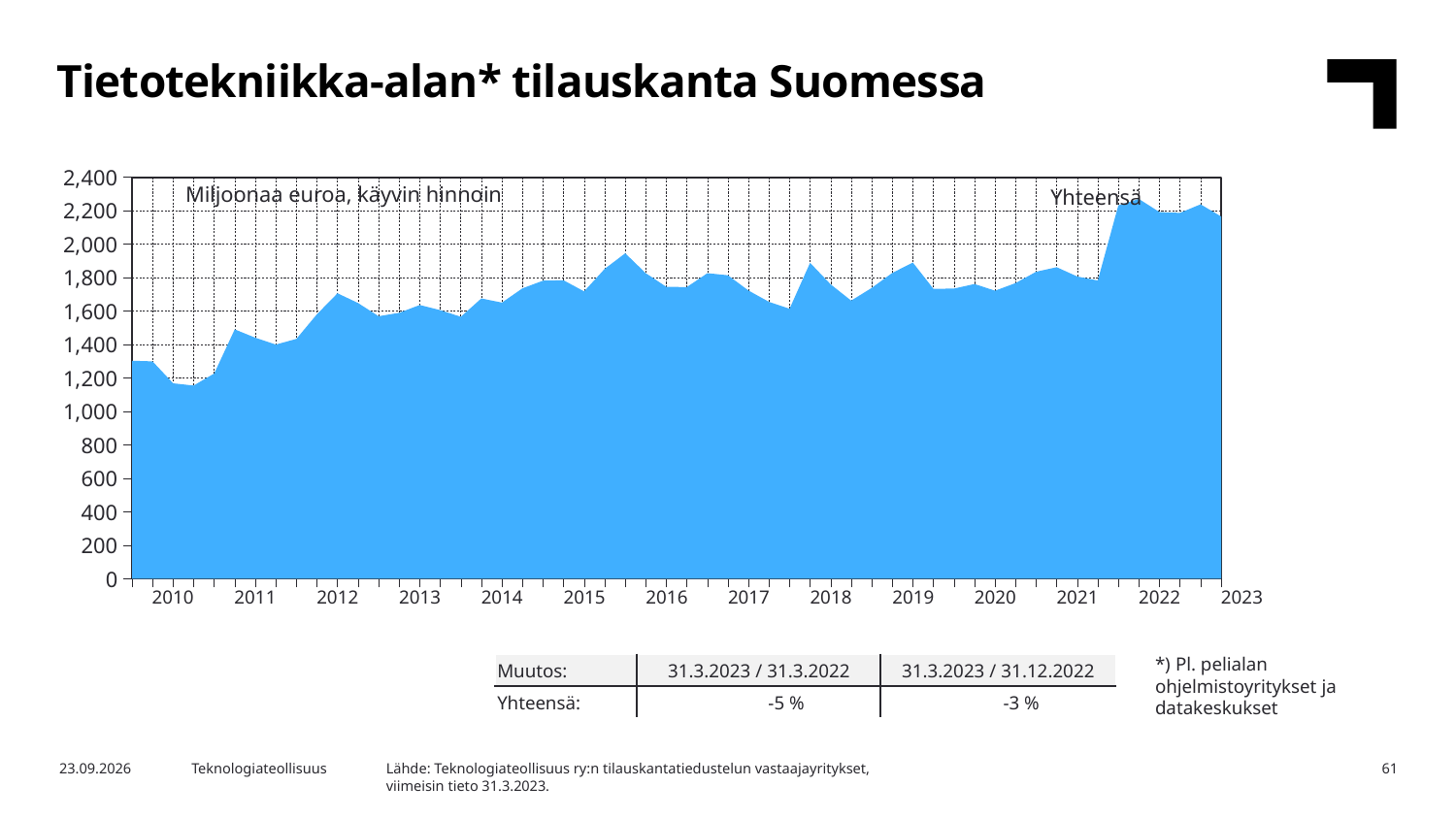
What is the title of the slide's chart? Tietotekniikka-alan* tilauskanta Suomessa In which year does the series reach its highest values? 2022 Is the value at the start of 2020 greater or less than 1,800? less Is the last plotted value in 2023 greater or less than 2,000? greater Is the highest value reached in 2022 greater or less than 2,000? greater In which year does the series reach its lowest values? 2010 What unit is stated inside the chart area? Miljoonaa euroa, käyvin hinnoin What kind of chart is shown on the slide? area chart Overall, do the values rise or fall from 2010 to 2023? rise